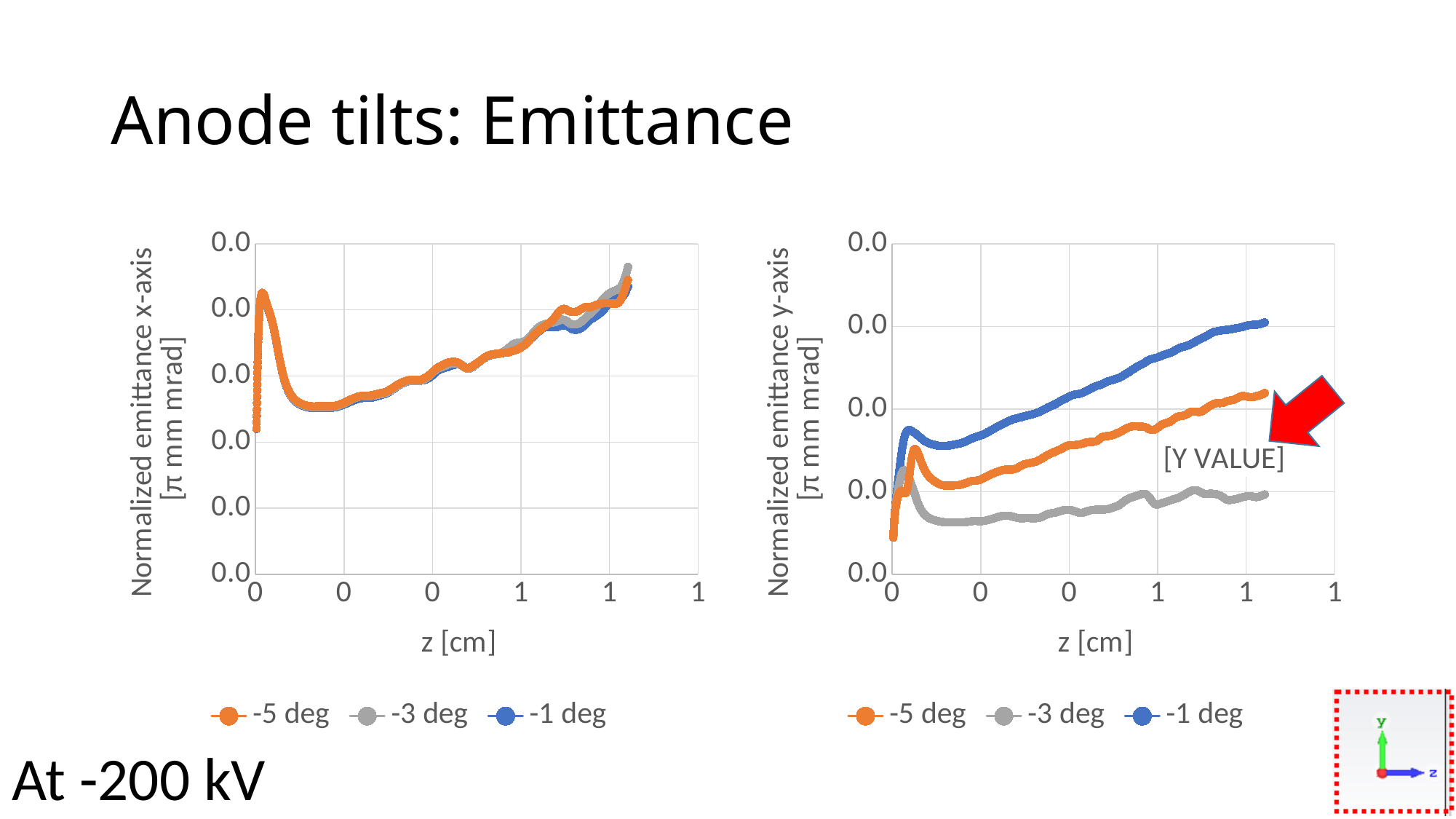
In the right chart, does the -1 deg series generally rise or fall as z increases beyond its initial dip? rise In the right chart, which series has the highest values at the right end of the z axis? -1 deg In the left chart, how many series does the legend list? 3 In the right chart, which series has the lowest values at the right end of the z axis? -3 deg In the right chart, at the right end of the z axis, is the -1 deg series or the -3 deg series higher? -1 deg What are the legend entries of the right chart? -5 deg, -3 deg, -1 deg How many charts are shown on the slide? 2 In the left chart, do the series generally rise or fall as z increases after the initial peak and dip? rise What kind of chart is the right chart (Normalized emittance y-axis)? line chart In the right chart, how many series does the legend list? 3 What is the x-axis title of the left chart? z [cm]